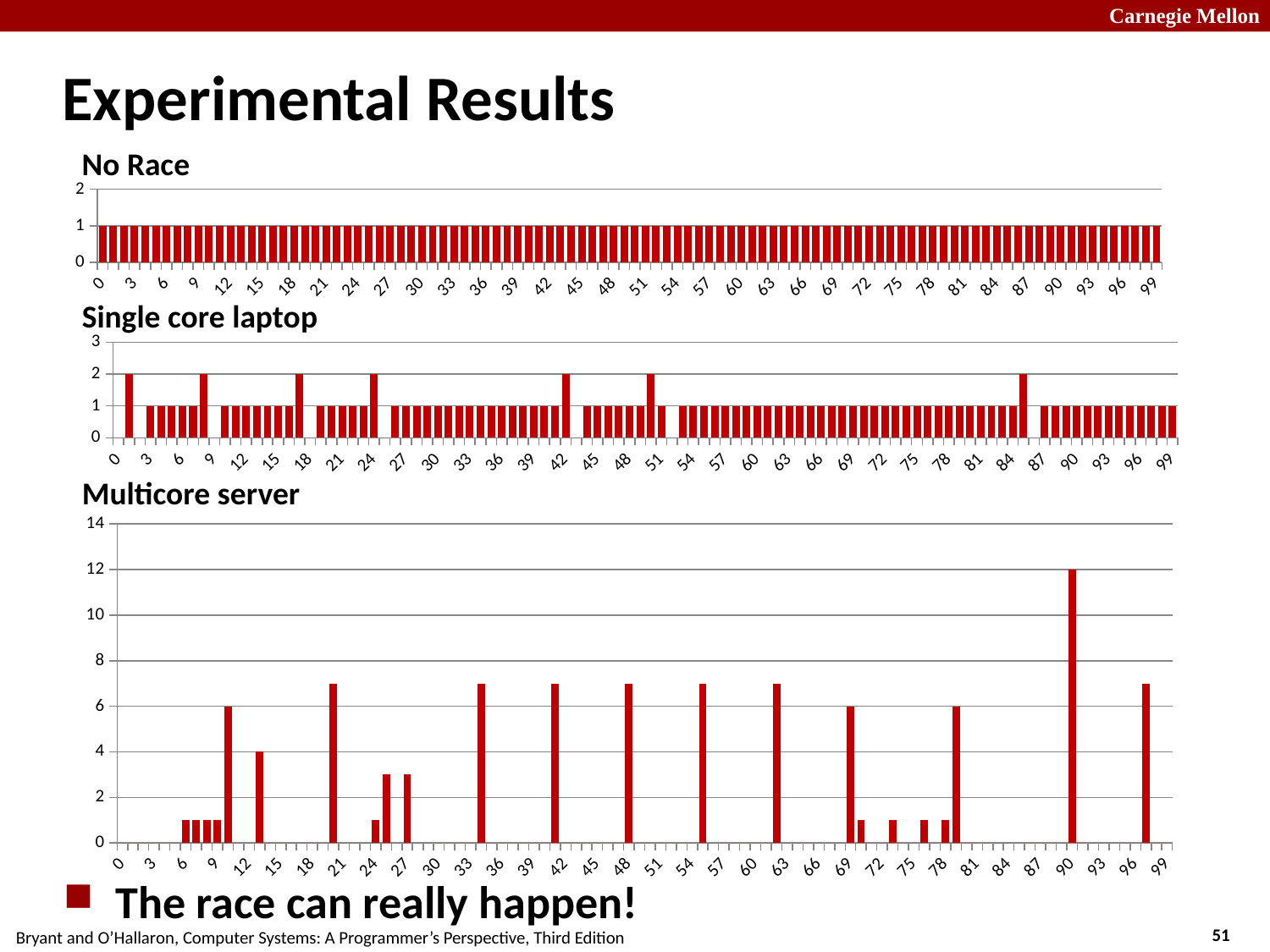
In the "Multicore server" chart, is the value at 90 greater or less than 10? greater In the "Single core laptop" chart, what is the highest value reached by any bar? 2 In the "Multicore server" chart, what is the highest tick shown on the y axis? 14 In the "Multicore server" chart, what is the value of the bar at 90? 12 In the "No Race" chart, what is the highest tick shown on the y axis? 2 In the "Multicore server" chart, which x-axis category has the highest bar? 90 What kind of chart is the "Multicore server" chart? bar chart In the "No Race" chart, what value does every bar reach? 1 How many charts are shown on the slide? 3